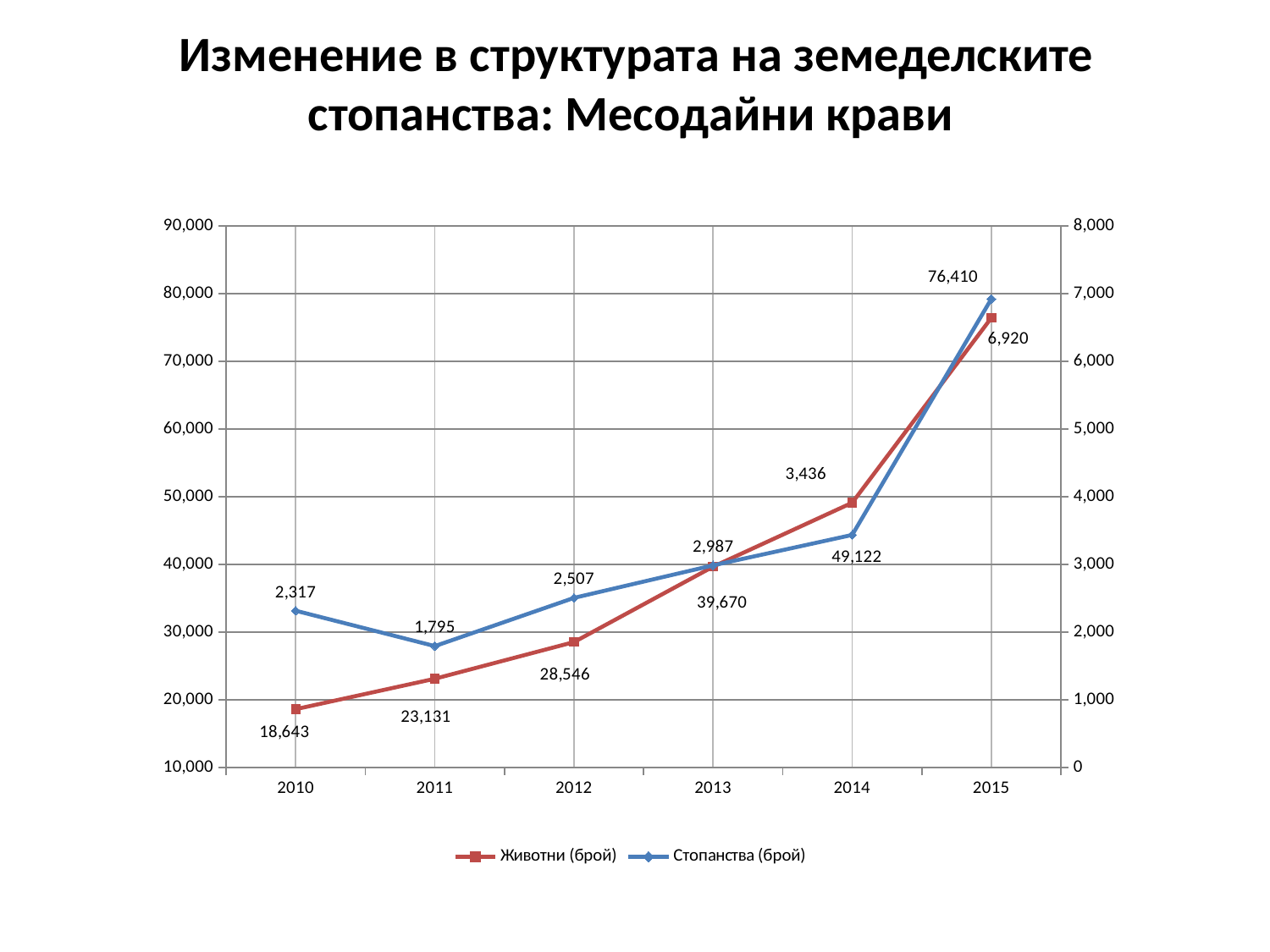
Which year has a larger value for Стопанства (брой), 2010 or 2012? 2012 What kind of chart is shown on the slide? Line chart How many series does the legend list? 2 What is the value of Стопанства (брой) in 2011? 1,795 In which year is Животни (брой) highest? 2015 What is the difference in Стопанства (брой) between 2012 and 2011? 712 What is the value of Животни (брой) in 2015? 76,410 What is the difference in Животни (брой) between 2015 and 2014? 27,288 Does Животни (брой) rise or fall from 2010 to 2015? Rise How many years are shown on the x axis? 6 What is the value of Животни (брой) in 2013? 39,670 In which year is Стопанства (брой) lowest? 2011